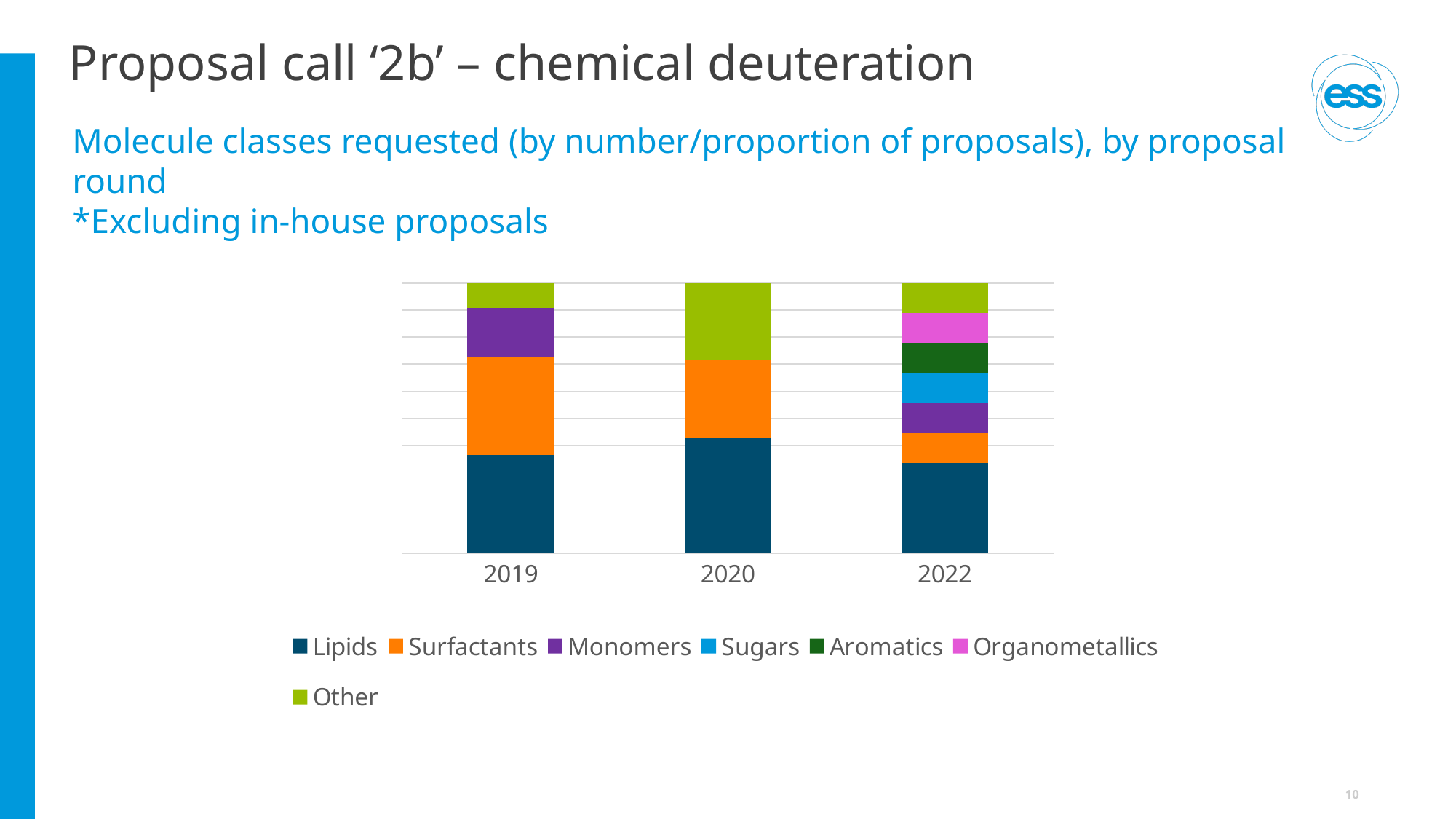
Which molecule class is shown at the bottom of each stacked bar? Lipids Which proposal rounds are shown on the x axis of the chart? 2019, 2020, 2022 How many series does the chart's legend list? 7 In the 2019 bar, which segment is larger: Lipids or Monomers? Lipids Which proposal round's bar contains the fewest molecule classes? 2020 What kind of chart is shown on the slide? Stacked bar chart In the 2022 bar, which segment is larger: Lipids or Surfactants? Lipids Which proposal round has the largest Surfactants segment in the chart? 2019 Which proposal round's bar contains the most molecule classes? 2022 How many proposal rounds (categories) are shown on the x axis of the chart? 3 Which proposal round has the largest 'Other' segment in the chart? 2020 Which proposal round has the smallest 'Other' segment in the chart? 2019